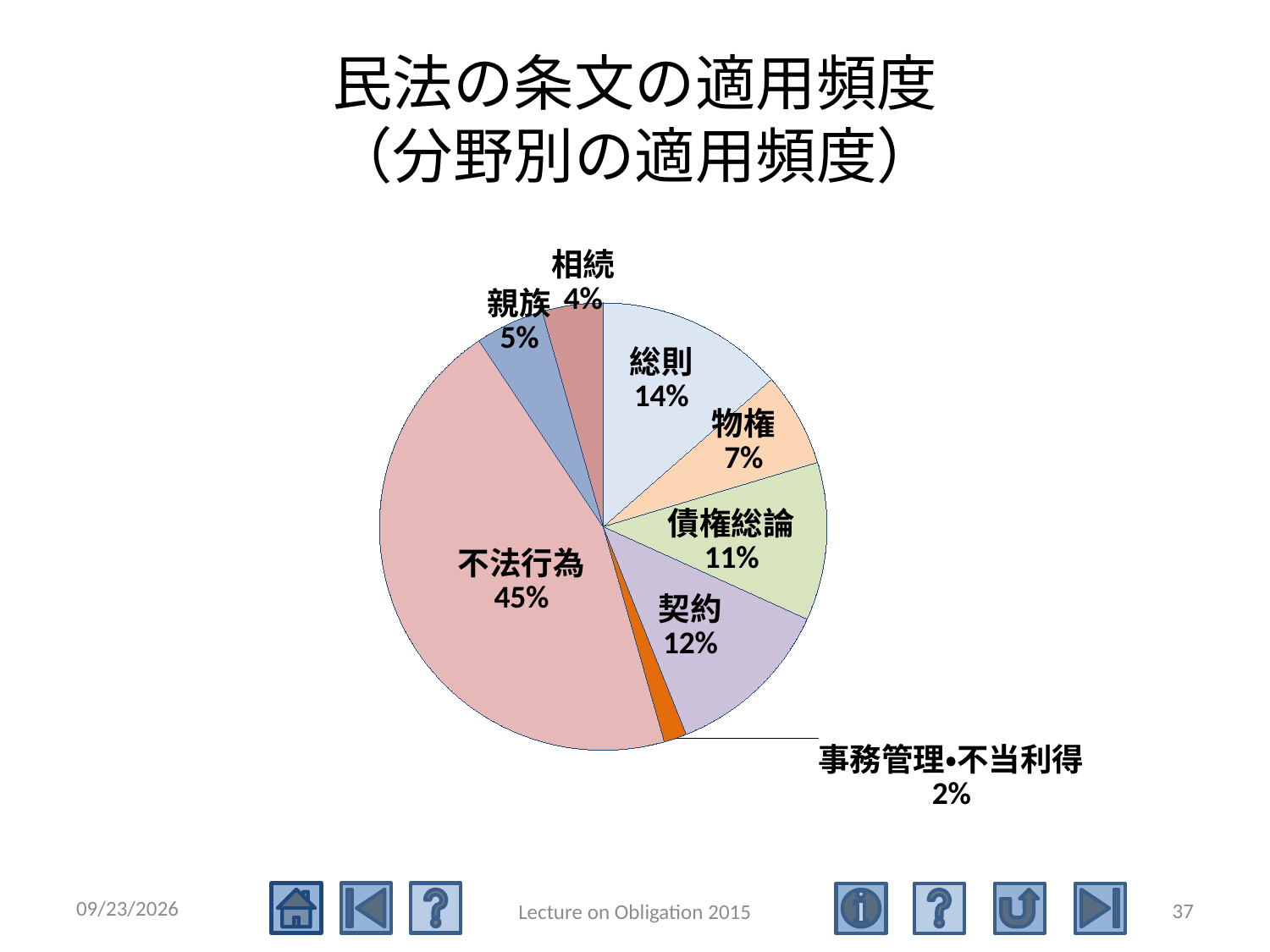
Which category has the smallest slice of the pie? 事務管理•不当利得 What is the value shown for 債権総論? 11% Which category has the largest slice of the pie? 不法行為 Which is larger, 契約 or 債権総論? 契約 What kind of chart is shown on the slide? pie chart What is the value shown for 総則? 14% What is the title of the slide containing the chart? 民法の条文の適用頻度（分野別の適用頻度） How many categories are shown in the pie chart? 8 What is the difference in percentage points between 親族 and 相続? 1 What share of the pie does 不法行為 account for? 45% What is the value shown for 事務管理•不当利得? 2% What is the difference in percentage points between 総則 and 物権? 7